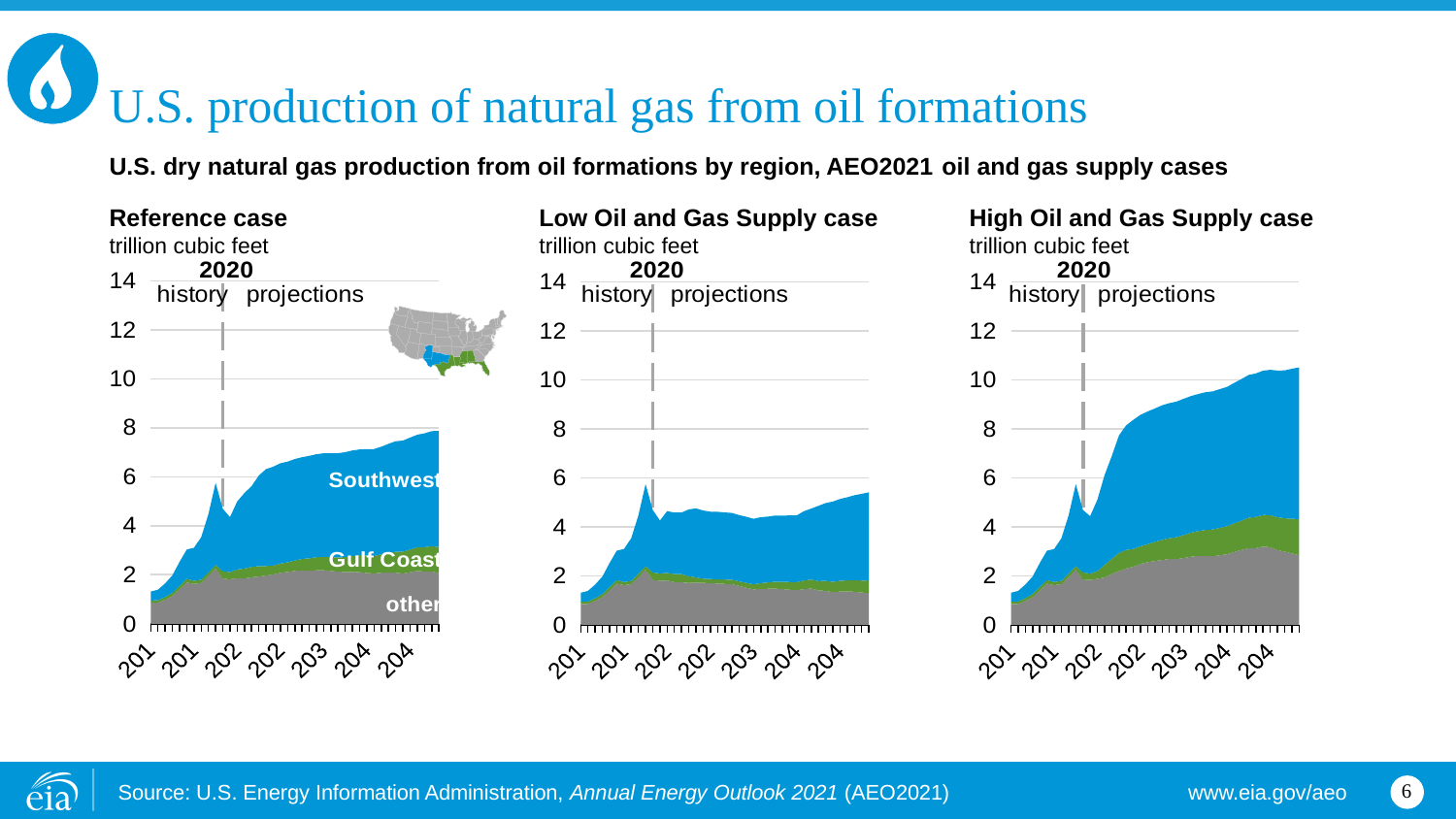
How many charts are shown on the slide? 3 In the High Oil and Gas Supply case chart, is the total production at the end of the projection period greater or less than 12? less In the Low Oil and Gas Supply case chart, is the total production at the end of the projection period greater or less than 4? greater In the Reference case chart, which region is shown as the top (blue) area? Southwest What kind of chart is the Reference case chart? stacked area chart Which of the three cases shows the highest total production at the end of the projection period? High Oil and Gas Supply case In the Reference case chart, is the total production at the end of the projection period greater or less than 6? greater What unit is used on the y axis of all three charts? trillion cubic feet In the Reference case chart, how many regions are labeled in the stacked areas? 3 In the High Oil and Gas Supply case chart, does total production rise or fall over the projection period? rise